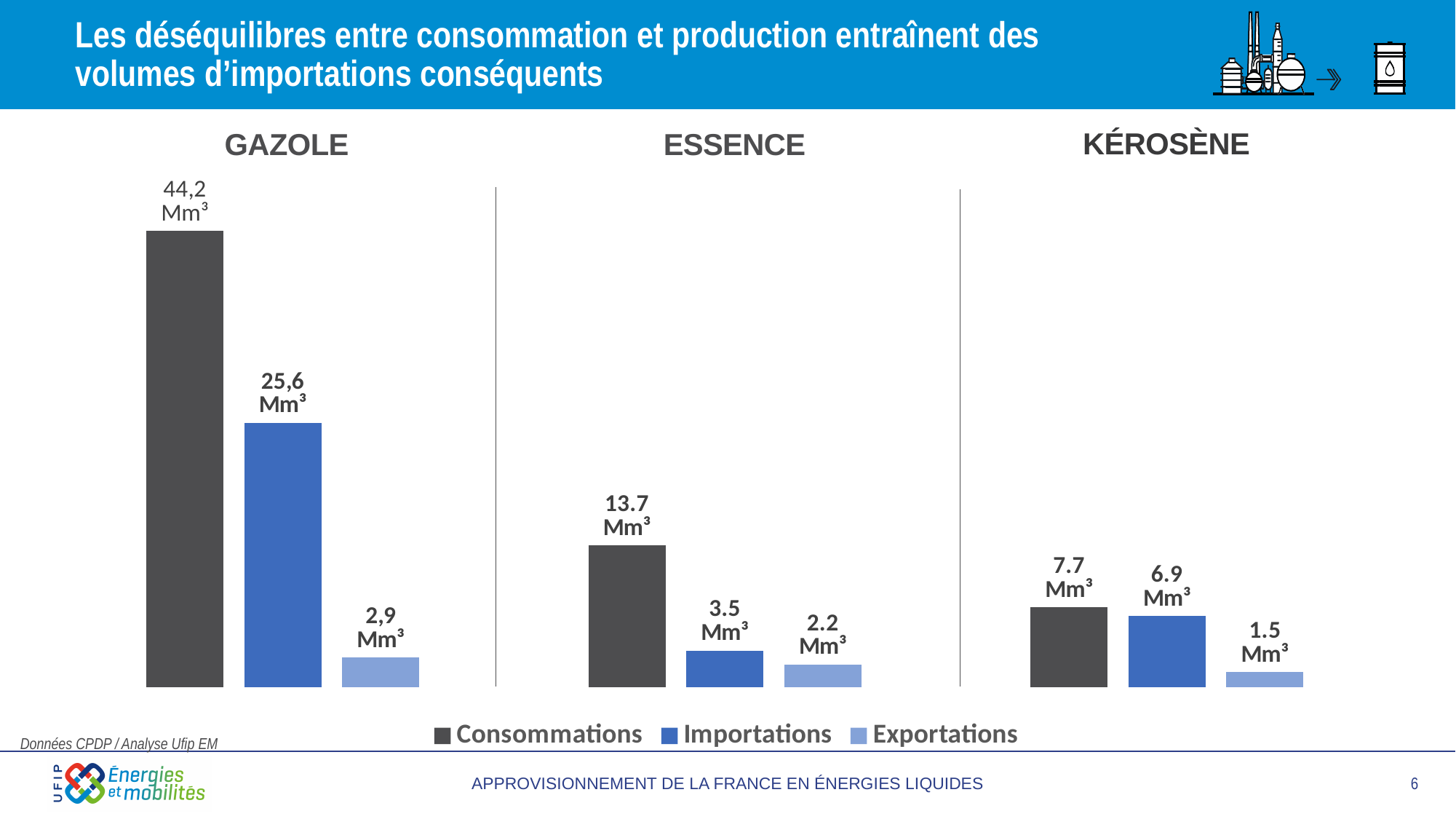
What is the Importations value for Essence? 3.5 Mm³ Which fuel has the lowest Exportations value? Kérosène What is the Exportations value for Kérosène? 1.5 Mm³ What is the difference between Consommations and Importations for Gazole? 18,6 Mm³ How many series does the legend list? 3 Which fuel has the highest Consommations value? Gazole What is the difference between Consommations and Exportations for Essence? 11.5 Mm³ What kind of chart is shown on the slide? Bar chart How many fuel categories are shown on the chart? 3 Which is larger: Importations for Gazole or Consommations for Essence? Importations for Gazole What is the Importations value for Kérosène? 6.9 Mm³ What is the Consommations value for Gazole? 44,2 Mm³